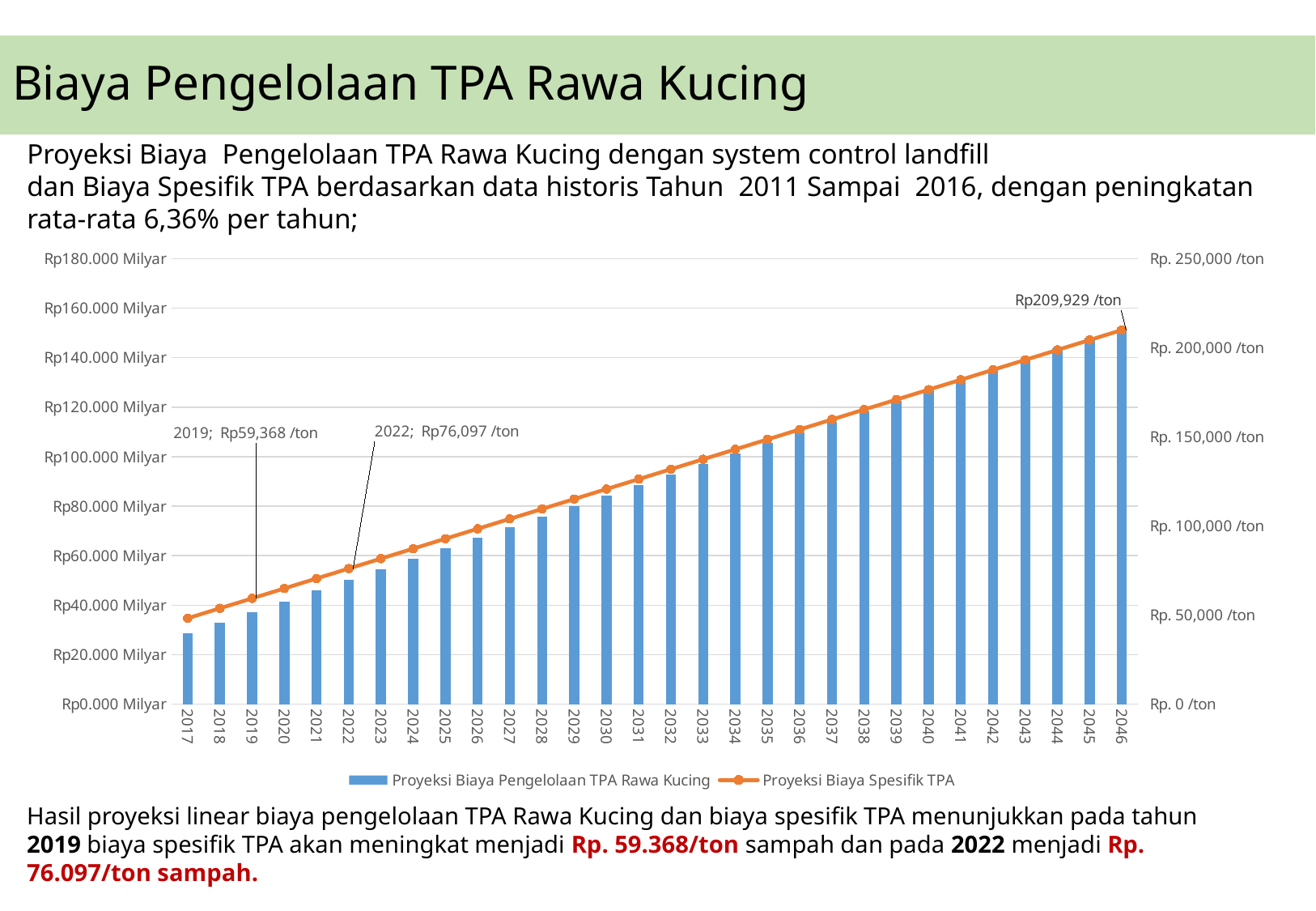
Do the values of Proyeksi Biaya Pengelolaan TPA Rawa Kucing rise or fall from 2017 to 2046? rise How many years are shown on the x axis of the chart? 30 Which year has the highest Proyeksi Biaya Pengelolaan TPA Rawa Kucing? 2046 Is the Proyeksi Biaya Pengelolaan TPA Rawa Kucing for 2017 greater or less than Rp40.000 Milyar? less What is the value of Proyeksi Biaya Spesifik TPA for 2046? Rp209,929 /ton Is the Proyeksi Biaya Spesifik TPA for 2040 greater or less than Rp. 150,000 /ton? greater How many series does the chart legend list? 2 Is the Proyeksi Biaya Pengelolaan TPA Rawa Kucing for 2046 greater or less than Rp140.000 Milyar? greater What is the value of Proyeksi Biaya Spesifik TPA for 2019? Rp59,368 /ton What is the value of Proyeksi Biaya Spesifik TPA for 2022? Rp76,097 /ton Which year has the lowest Proyeksi Biaya Pengelolaan TPA Rawa Kucing? 2017 By how much does Proyeksi Biaya Spesifik TPA increase from 2019 to 2022? Rp16,729 /ton